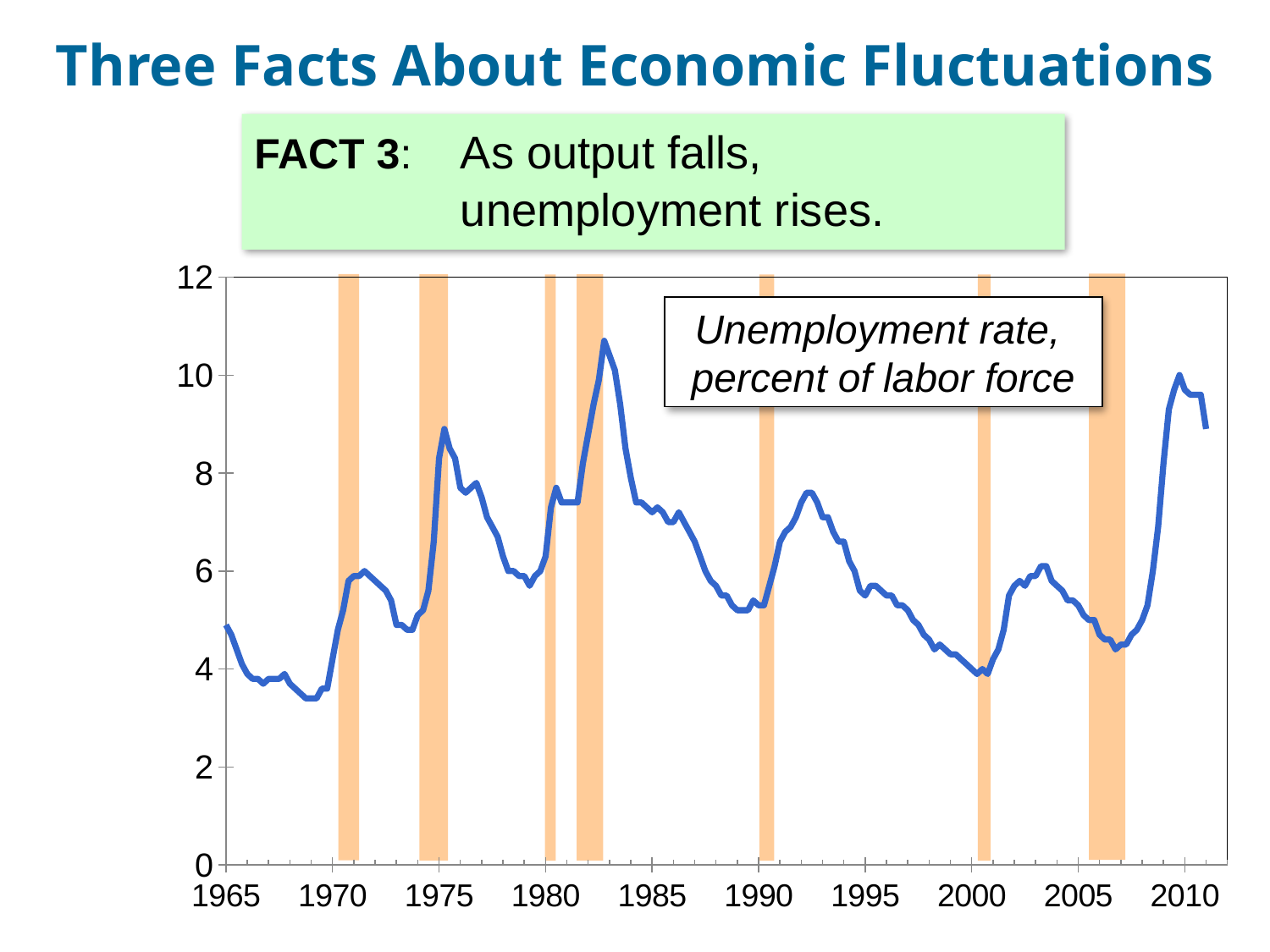
How many data lines are plotted on the chart? 1 How many shaded vertical bands are drawn on the chart? 7 Is the peak of the line around 1983 higher or lower than the peak around 2010? higher What kind of chart is shown on the slide? line chart Is the peak unemployment rate around 1983 greater or less than 10? greater Is the unemployment rate in 1965 greater or less than 6? less What does the text box inside the chart say the line represents? Unemployment rate, percent of labor force Does the unemployment rate rise or fall between 1983 and 1989? fall Does the unemployment rate rise or fall between 2007 and 2009? rise Is the unemployment rate in 1975 greater or less than 8? greater